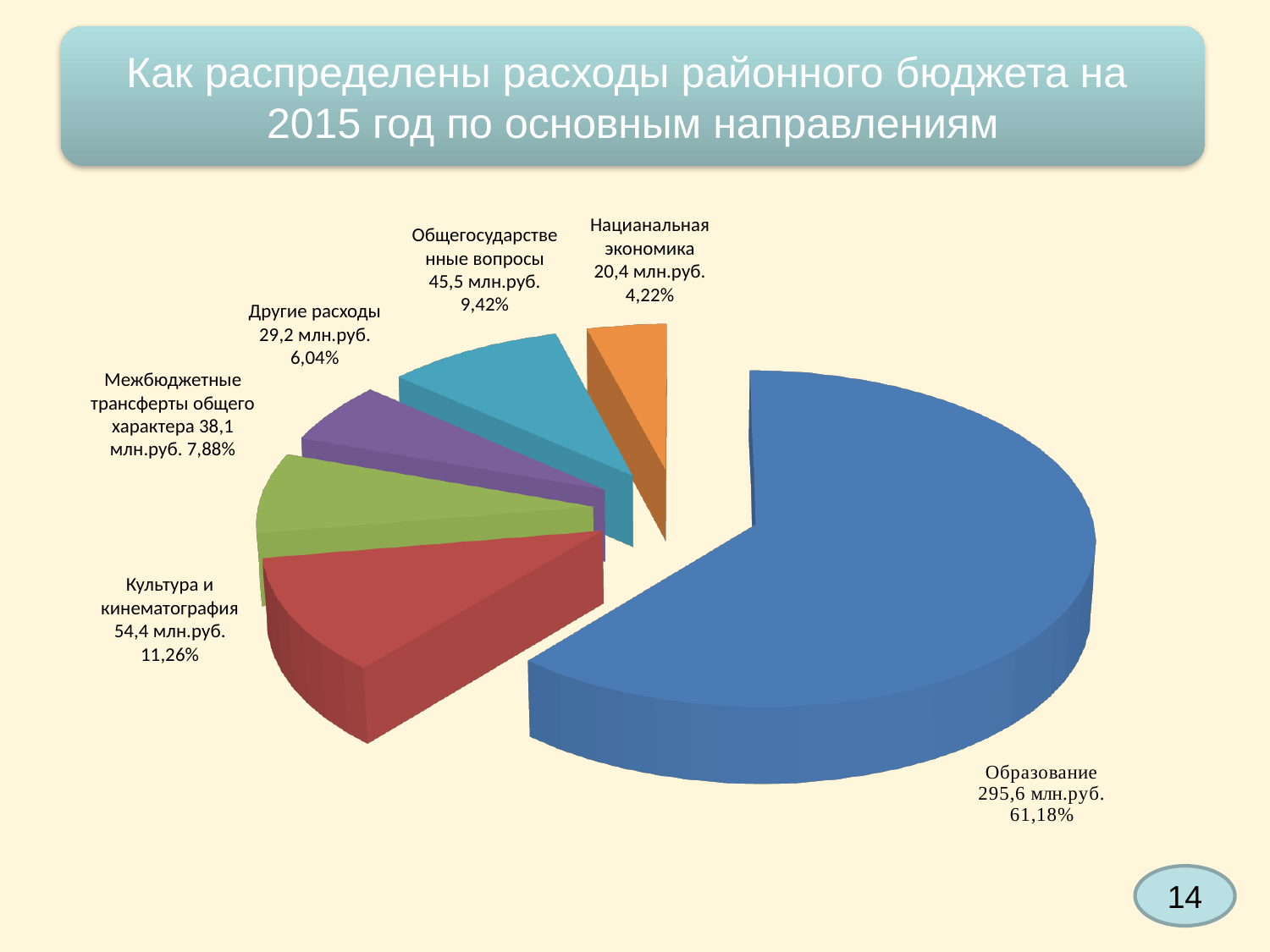
What is the title of the slide containing the chart? Как распределены расходы районного бюджета на 2015 год по основным направлениям What type of chart is shown on the slide? Pie chart What percentage is shown for Общегосударственные вопросы? 9,42% Which category has the largest share of the budget expenses? Образование What is the difference between Культура и кинематография and Общегосударственные вопросы in млн.руб.? 8,9 млн.руб. What share of the pie does Образование represent? 61,18% What is the value for Культура и кинематография? 54,4 млн.руб. How many categories (slices) does the pie chart show? 6 What is the value for Межбюджетные трансферты общего характера? 38,1 млн.руб. Which category has the smallest share of the budget expenses? Нацианальная экономика What is the value for Образование? 295,6 млн.руб. Which is larger: Другие расходы or Общегосударственные вопросы? Общегосударственные вопросы